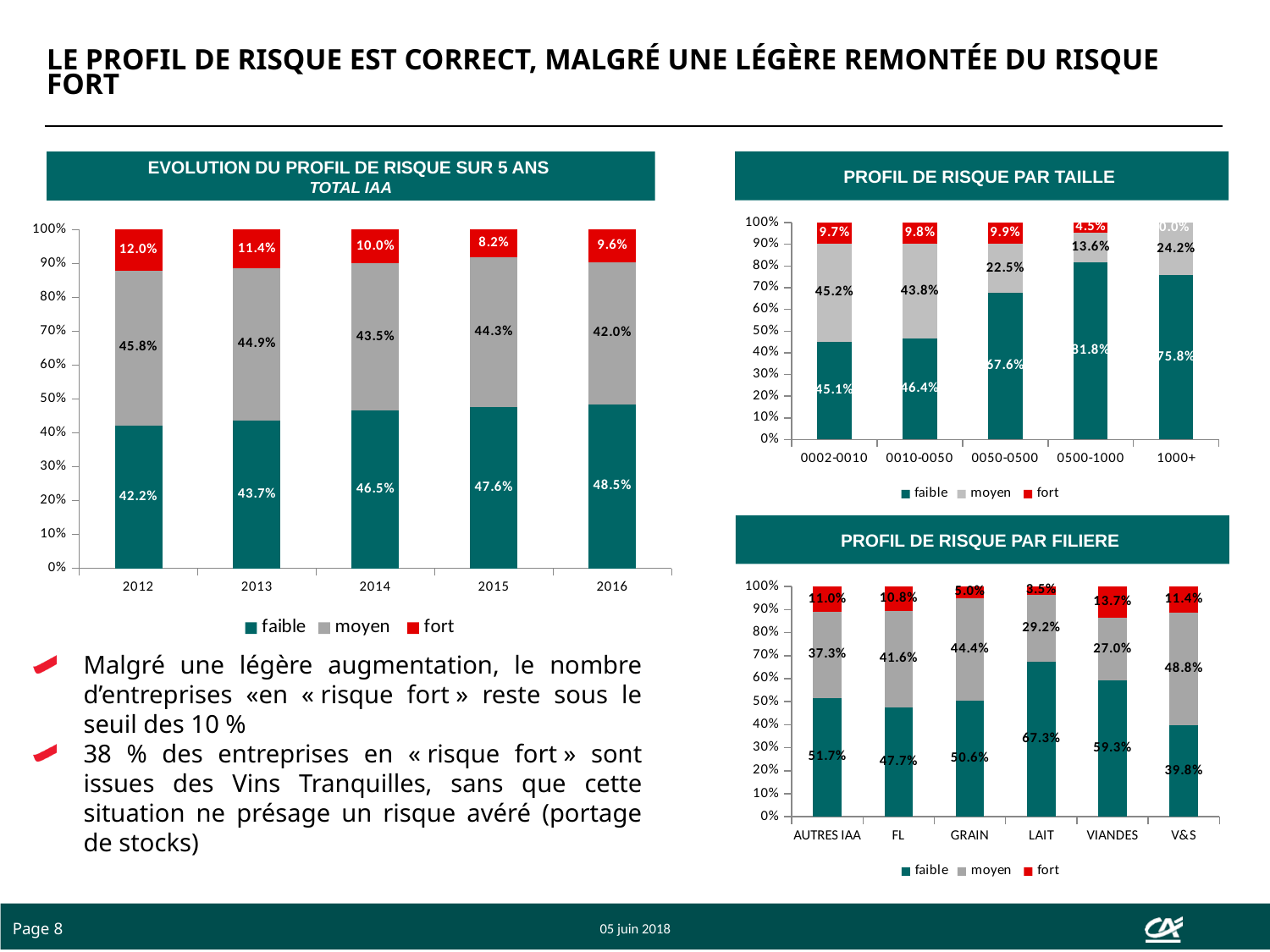
In the chart 'PROFIL DE RISQUE PAR TAILLE', which category has the highest 'moyen' value? 0002-0010 In the chart 'PROFIL DE RISQUE PAR FILIERE', what is the 'fort' value for VIANDES? 13.7% In the chart 'EVOLUTION DU PROFIL DE RISQUE SUR 5 ANS', what is the value of 'faible' for 2016? 48.5% In the chart 'EVOLUTION DU PROFIL DE RISQUE SUR 5 ANS', does the 'faible' series rise or fall from 2012 to 2016? rise In the chart 'PROFIL DE RISQUE PAR TAILLE', is the 'faible' value for 0050-0500 larger or smaller than for 0010-0050? larger In the chart 'PROFIL DE RISQUE PAR FILIERE', which filière has the lowest 'faible' value? V&S In the chart 'PROFIL DE RISQUE PAR TAILLE', what is the 'faible' value for the 0500-1000 category? 81.8% How many series does the legend list in the chart 'PROFIL DE RISQUE PAR FILIERE'? 3 How many years are shown in the chart 'EVOLUTION DU PROFIL DE RISQUE SUR 5 ANS'? 5 In the chart 'EVOLUTION DU PROFIL DE RISQUE SUR 5 ANS', what is the value of 'fort' for 2012? 12.0% In the chart 'EVOLUTION DU PROFIL DE RISQUE SUR 5 ANS', which year has the lowest 'fort' value? 2015 In the chart 'EVOLUTION DU PROFIL DE RISQUE SUR 5 ANS', what is the difference between the 'moyen' values for 2012 and 2016? 3.8%